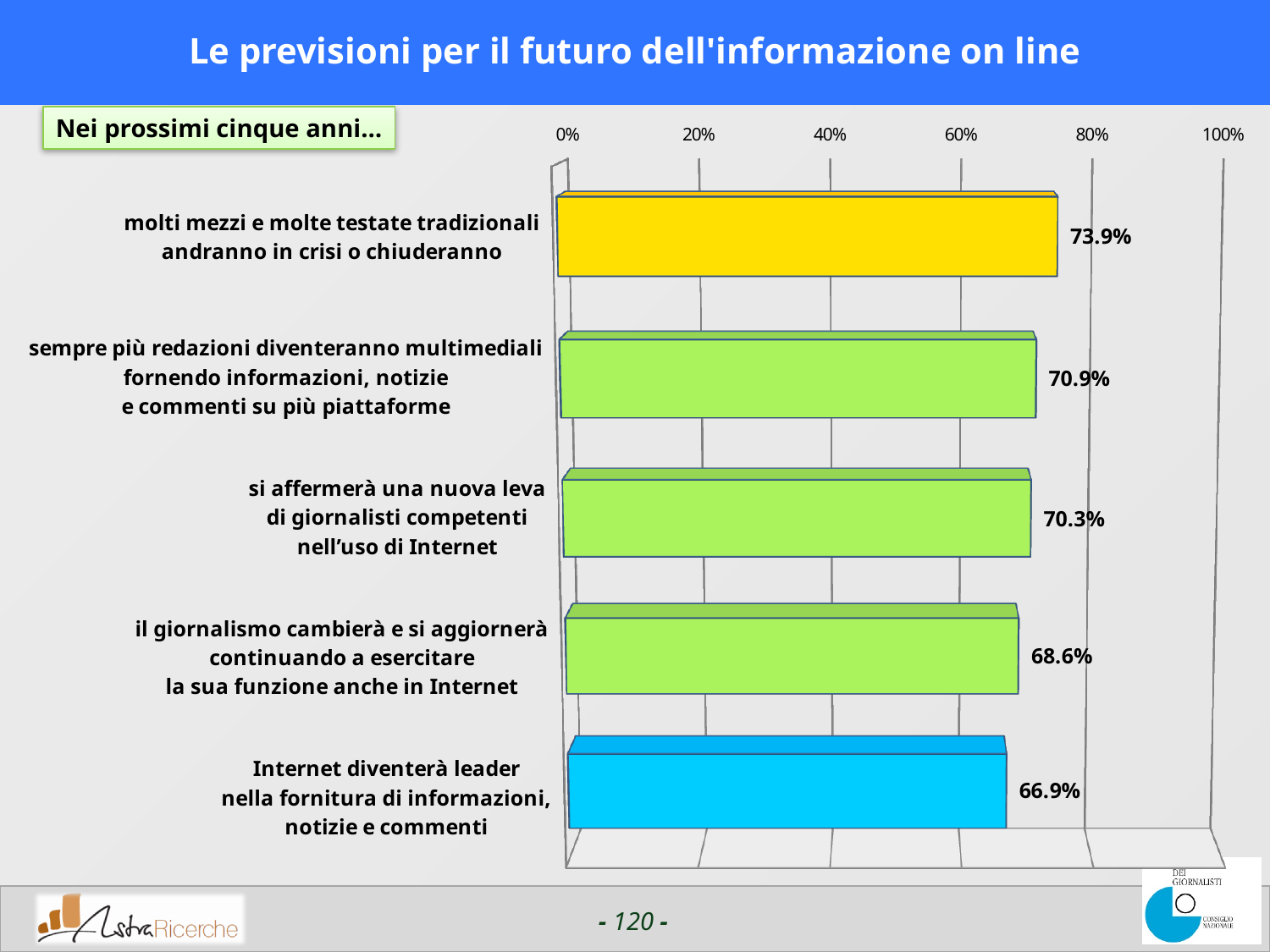
Which category has the highest value? molti mezzi e molte testate tradizionali andranno in crisi o chiuderanno Is the value for "il giornalismo cambierà e si aggiornerà" greater or less than 60%? greater What is the difference between the values for "sempre più redazioni diventeranno multimediali" and "il giornalismo cambierà e si aggiornerà"? 2.3% How many categories are shown in the chart? 5 Which is larger: the value for "sempre più redazioni diventeranno multimediali" or the value for "il giornalismo cambierà e si aggiornerà"? sempre più redazioni diventeranno multimediali What kind of chart is shown on the slide? bar chart What is the value for "Internet diventerà leader nella fornitura di informazioni, notizie e commenti"? 66.9% What colour is the bar for "Internet diventerà leader nella fornitura di informazioni, notizie e commenti"? blue What is the difference between the values for "molti mezzi e molte testate tradizionali andranno in crisi o chiuderanno" and "Internet diventerà leader nella fornitura di informazioni, notizie e commenti"? 7.0% What is the value for "molti mezzi e molte testate tradizionali andranno in crisi o chiuderanno"? 73.9% What is the value for "si affermerà una nuova leva di giornalisti competenti nell'uso di Internet"? 70.3% Which category has the lowest value? Internet diventerà leader nella fornitura di informazioni, notizie e commenti